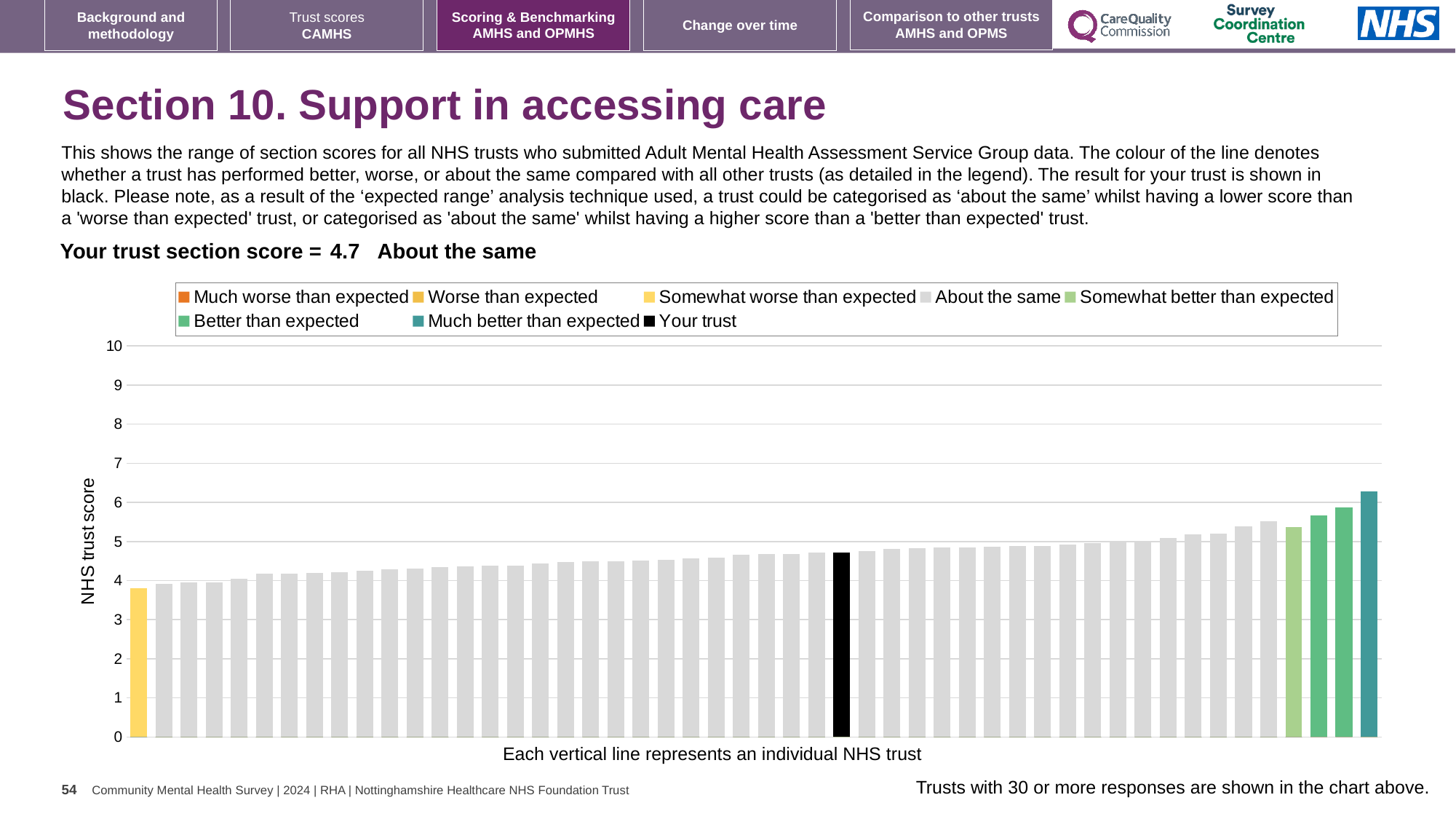
What kind of chart is shown on the slide? bar chart Which performance category is your trust placed in? About the same Which legend category does the shortest bar belong to? Somewhat worse than expected Which legend category does the tallest bar belong to? Much better than expected How many entries does the chart legend list? 8 Is the value for your trust (the black bar) greater or less than 4? greater What is the label on the y axis of the chart? NHS trust score What is the section score for your trust? 4.7 Is the value of the tallest bar (much better than expected) greater or less than 6? greater How many bars are coloured as 'Better than expected' (mid green)? 2 Is the value of the leftmost bar (worse than expected) greater or less than 4? less Do the bar values rise or fall from left to right along the x axis? rise